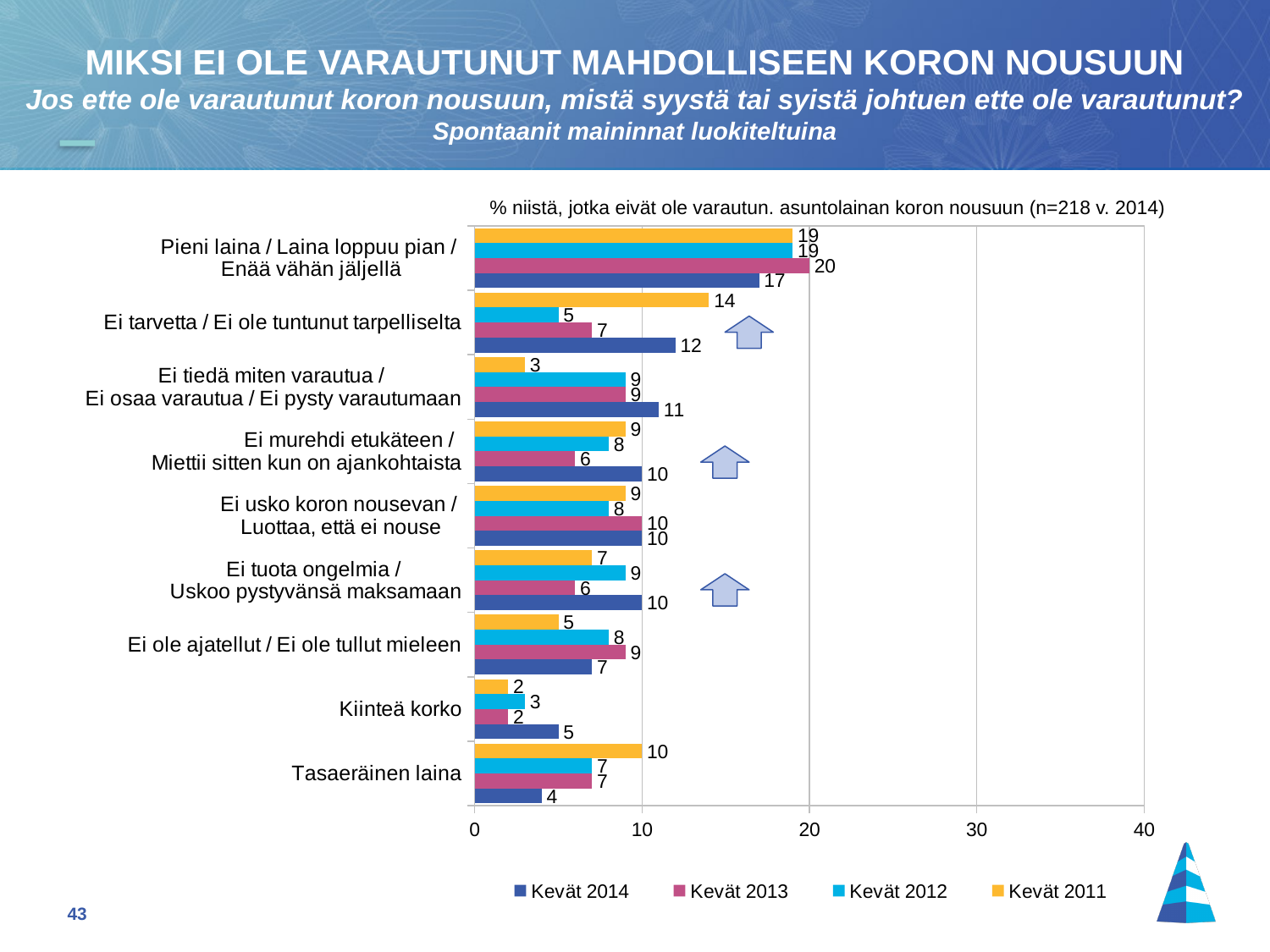
Which category has the lowest Kevät 2011 value? Kiinteä korko Is the Kevät 2013 value for "Pieni laina / Laina loppuu pian / Enää vähän jäljellä" greater or less than 10? greater What is the Kevät 2013 value for "Ei ole ajatellut / Ei ole tullut mieleen"? 9 How many series does the legend list? 4 Which series is shown in yellow in the legend? Kevät 2011 What is the Kevät 2014 value for "Pieni laina / Laina loppuu pian / Enää vähän jäljellä"? 17 What kind of chart is shown on the slide? Bar chart What is the Kevät 2011 value for "Ei tarvetta / Ei ole tuntunut tarpelliselta"? 14 What is the difference between the Kevät 2011 and Kevät 2014 values for "Tasaeräinen laina"? 6 Which category has the highest Kevät 2014 value? Pieni laina / Laina loppuu pian / Enää vähän jäljellä For "Ei tiedä miten varautua / Ei osaa varautua / Ei pysty varautumaan", which is larger: the Kevät 2014 value or the Kevät 2011 value? Kevät 2014 How many categories are shown on the chart? 9